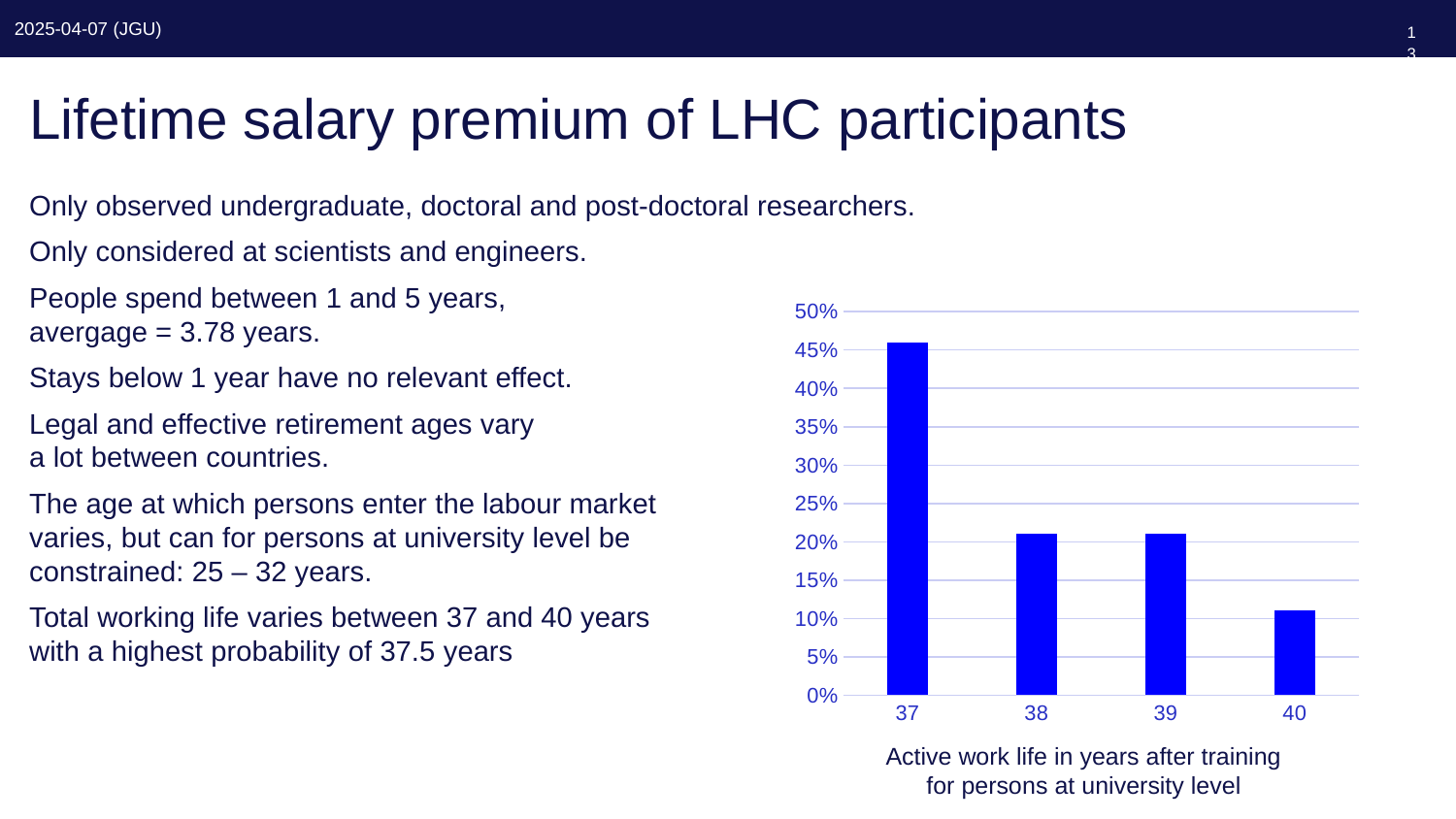
What is the caption printed below the x axis of the chart? Active work life in years after training for persons at university level Is the value for 39 greater or less than 25%? less Which has the larger value, 37 or 38? 37 Is the value for 37 greater or less than 50%? less How many categories are shown on the x axis of the chart? 4 Which category has the highest bar in the chart? 37 Which category has the lowest bar in the chart? 40 Which has the larger value, 39 or 40? 39 What kind of chart is shown on the slide? bar chart